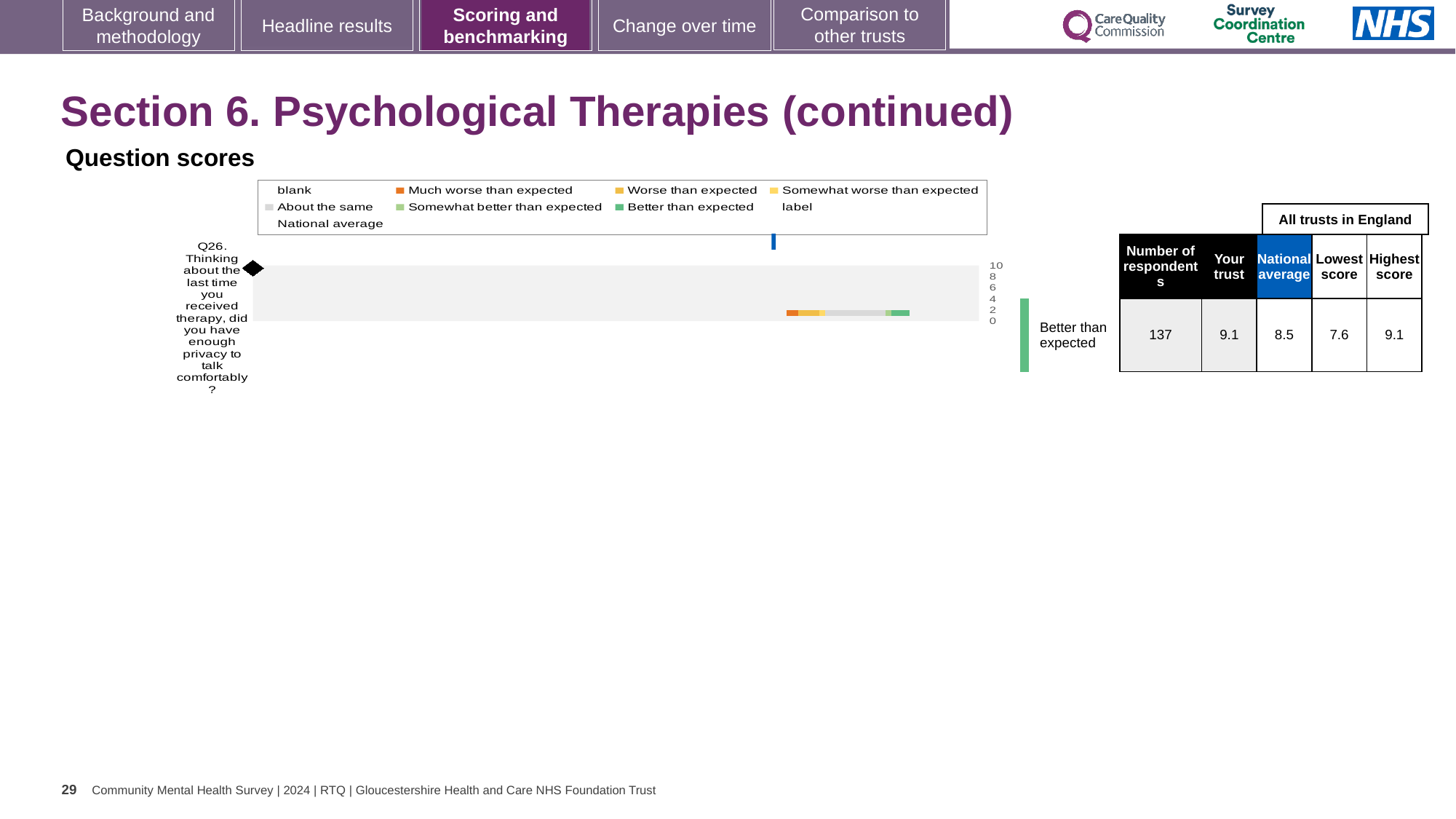
Which is larger for Q26: the 'Your trust' score or the national average? Your trust What is the highest value shown on the chart's axis? 10 How many questions (categories) are plotted in the chart? 1 How many respondents answered Q26 according to the table beside the chart? 137 In the table beside the chart, what is the highest score among all trusts in England for Q26? 9.1 In the table beside the chart, what is the 'Your trust' score for Q26? 9.1 What is the difference between the 'Your trust' score and the national average for Q26? 0.6 Which question is plotted in the chart? Q26. Thinking about the last time you received therapy, did you have enough privacy to talk comfortably? What rating label is shown next to the chart for Q26? Better than expected In the table beside the chart, what is the lowest score among all trusts in England for Q26? 7.6 In the table beside the chart, what is the national average score for Q26? 8.5 What kind of chart is shown under 'Question scores'? bar chart